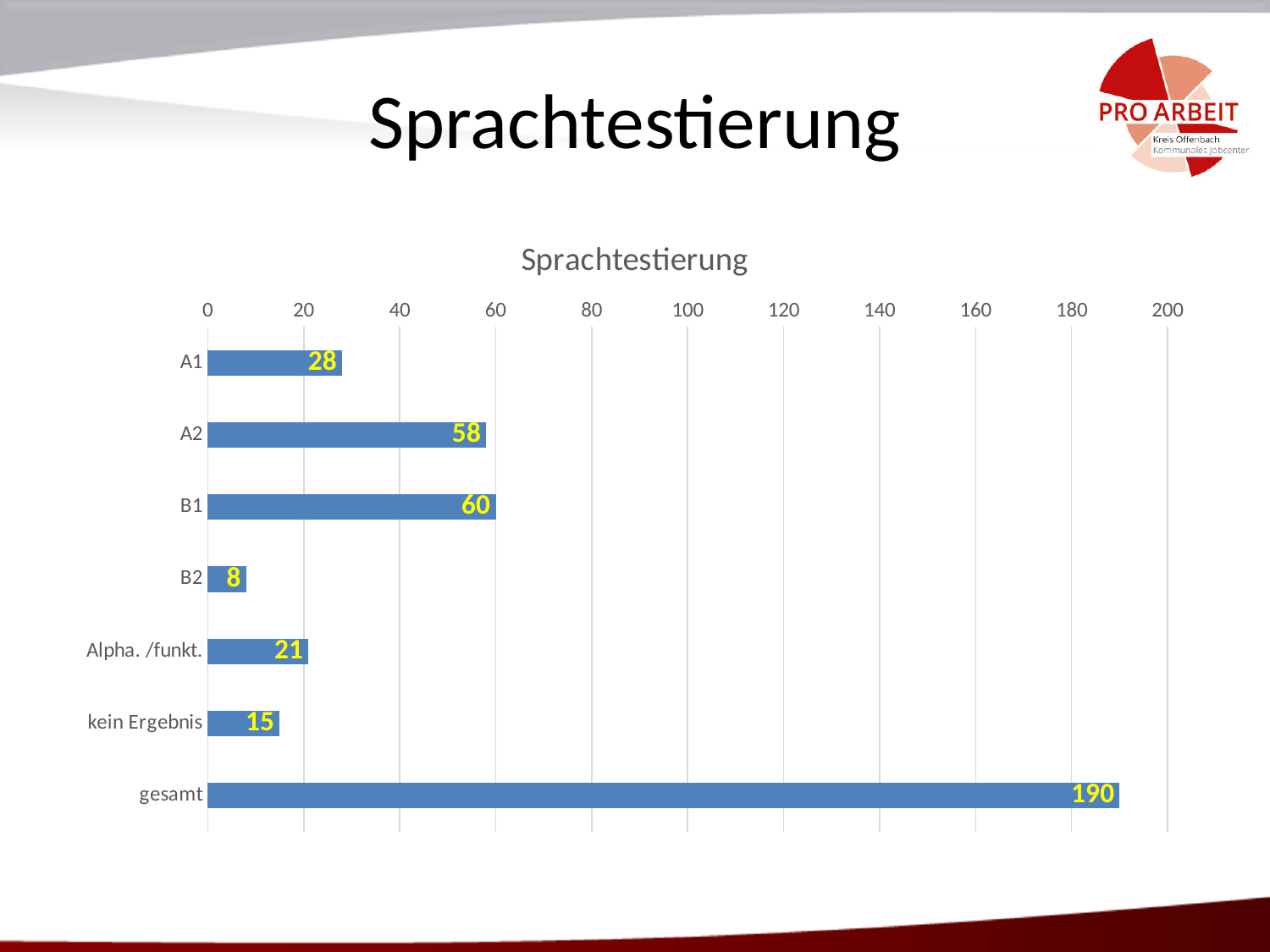
What kind of chart is shown on the slide? bar chart What is the difference between the values for A2 and A1? 30 What is the title of the chart? Sprachtestierung Is the value for gesamt greater or less than 180? greater Which category has the highest value? gesamt What is the value for A1? 28 Which is larger, the value for Alpha. /funkt. or the value for kein Ergebnis? Alpha. /funkt. What is the value for B1? 60 Which category has the lowest value? B2 What is the value for kein Ergebnis? 15 What is the value for gesamt? 190 How many categories are shown in the chart? 7